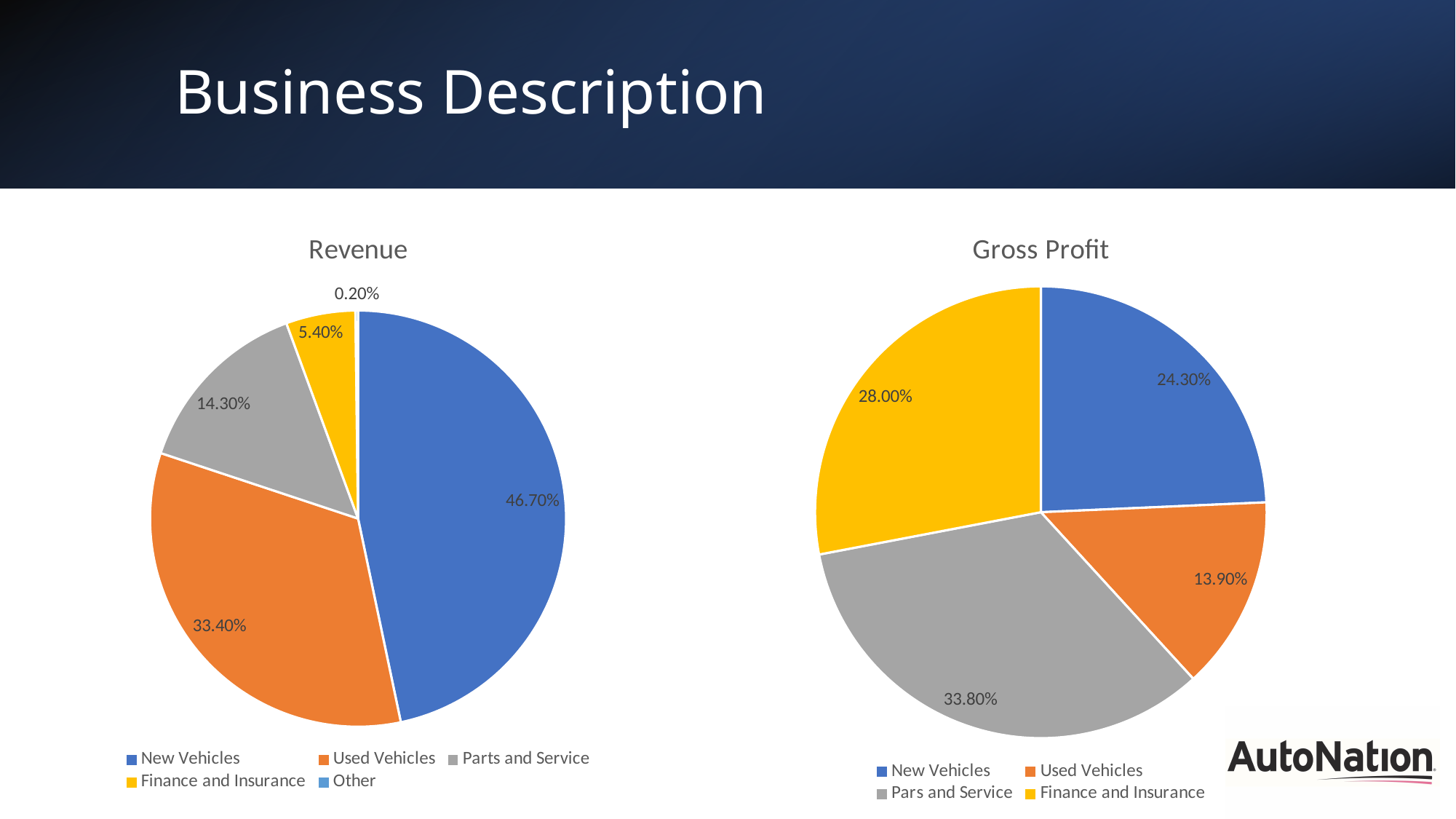
In the Revenue chart, what share does Parts and Service have? 14.30% In the Gross Profit chart, which category has the largest slice? Pars and Service In the Gross Profit chart, which category has the smallest slice? Used Vehicles In the Gross Profit chart, which is larger: New Vehicles or Finance and Insurance? Finance and Insurance In the Gross Profit chart, what share does Finance and Insurance have? 28.00% In the Revenue chart, which category has the smallest slice? Other In the Revenue chart, which category has the largest slice? New Vehicles In the Revenue chart, what is the difference between the Used Vehicles share and the Parts and Service share? 19.10% In the Revenue chart, what share does New Vehicles have? 46.70% What kind of chart is the Gross Profit chart? Pie chart How many categories does the Revenue chart's legend list? 5 In the Gross Profit chart, what share does Used Vehicles have? 13.90%